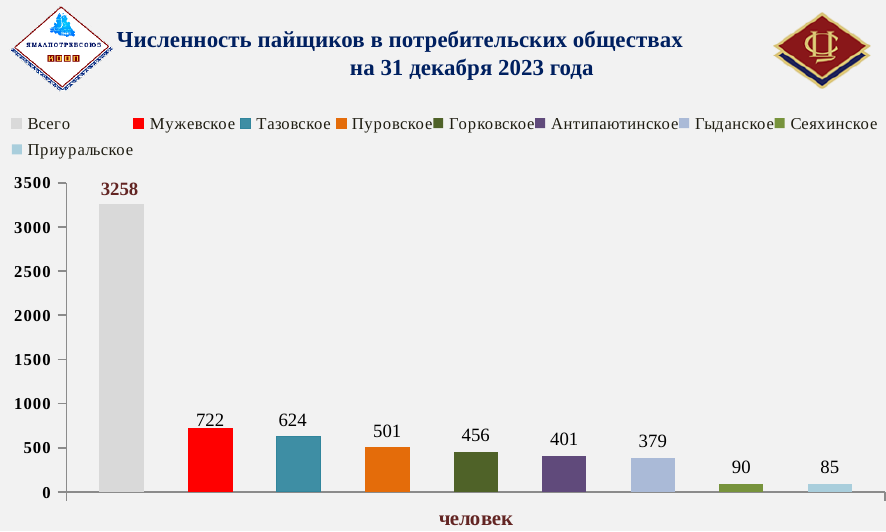
Is the value for Всего greater or less than 3000? greater How many bars are plotted in the chart? 9 Which category has the highest value? Всего How many entries does the legend list? 9 Which category has the lowest value? Приуральское What is the value for Гыданское? 379 What unit label is shown below the x axis? человек What is the difference between the values for Тазовское and Пуровское? 123 Which is larger, the value for Горковское or the value for Антипаютинское? Горковское What is the value for Приуральское? 85 What is the value for Мужевское? 722 What kind of chart is shown on the slide? bar chart